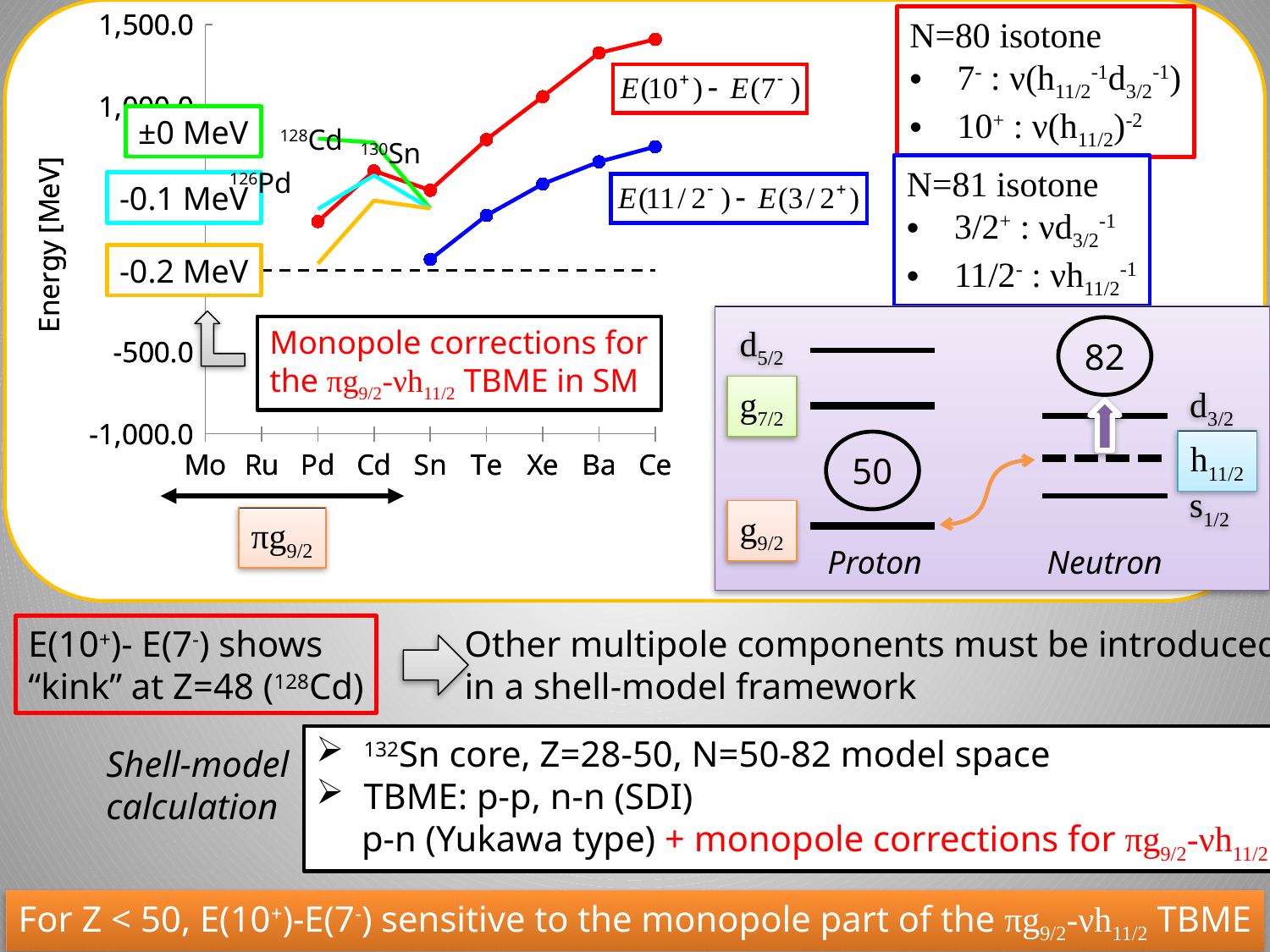
Which element has the lowest value in the E(10+) - E(7-) series? Pd Does the E(11/2-) - E(3/2+) series rise or fall from Sn to Ce? rise Which element has the highest value in the E(10+) - E(7-) series? Ce What is the title of the y axis of the chart? Energy [MeV] At Ce, which series has the larger value: E(10+) - E(7-) or E(11/2-) - E(3/2+)? E(10+) - E(7-) What kind of chart is shown on the slide? line chart Which element has the lowest value in the E(11/2-) - E(3/2+) series? Sn Is the E(10+) - E(7-) value for Ce greater or less than 1,000.0? greater Is the E(10+) - E(7-) value for Pd greater or less than 500.0? less Is the E(11/2-) - E(3/2+) value for Sn greater or less than 500.0? less Which series is drawn in blue on the chart? E(11/2-) - E(3/2+) How many element categories are listed along the x axis of the chart? 9